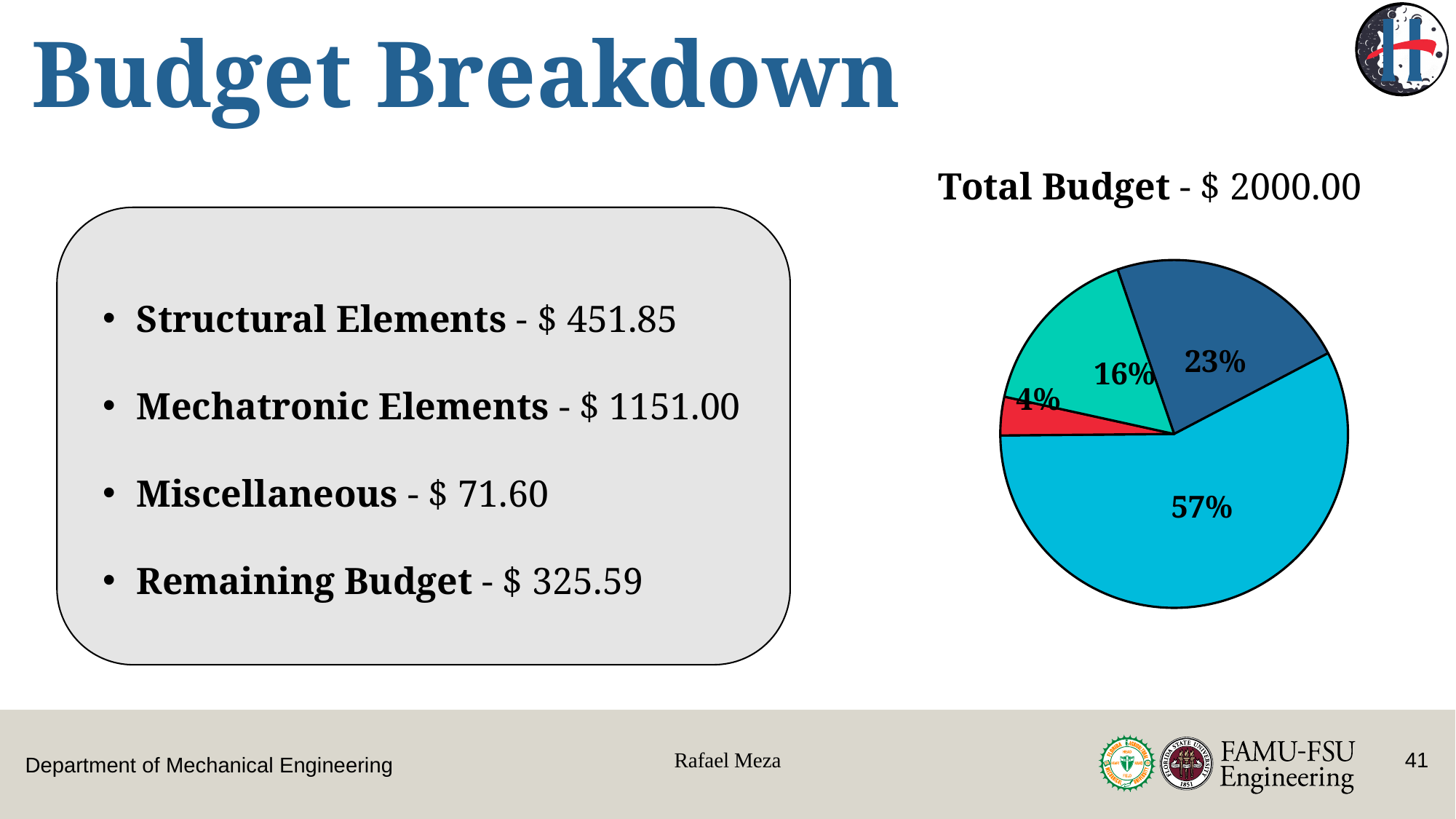
Which slice is larger in the pie chart, the one labelled 23% or the one labelled 16%? 23% What percentage is shown on the light blue slice of the pie chart? 57% What percentage is shown on the dark blue slice of the pie chart? 23% How many slices does the pie chart have? 4 What percentage is shown on the red slice of the pie chart? 4% By how many percentage points does the largest slice of the pie chart exceed the smallest slice? 53 percentage points What total budget is stated above the pie chart? $ 2000.00 What percentage is shown on the green slice of the pie chart? 16% Is the largest slice of the pie chart more or less than half of the pie? more What is the percentage shown on the smallest slice of the pie chart? 4% What is the percentage shown on the largest slice of the pie chart? 57% What kind of chart is shown on the slide? pie chart